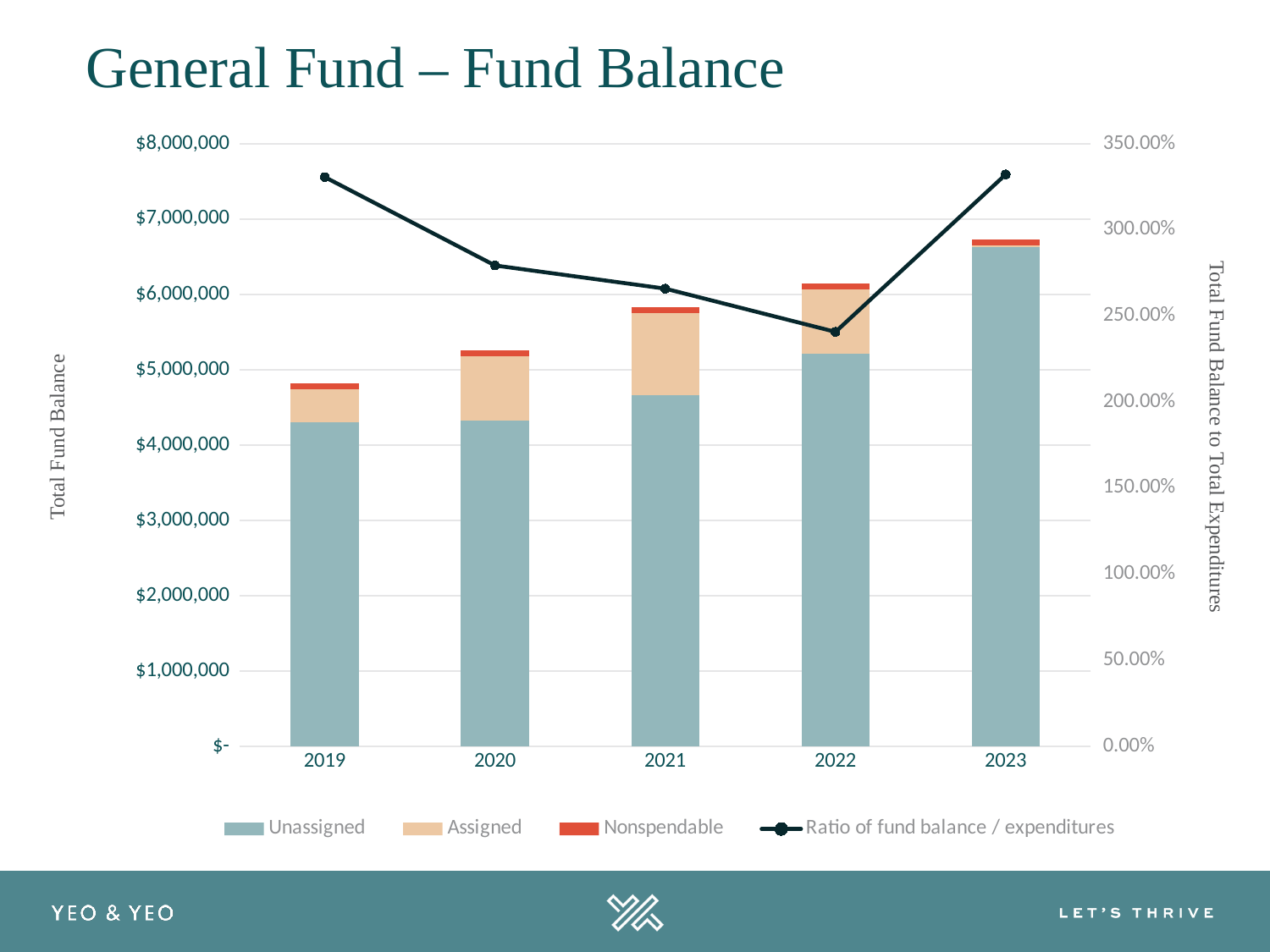
Is the total fund balance for 2019 greater or less than $5,000,000? less Which year has the largest Assigned segment? 2021 Does the total fund balance rise or fall from 2019 to 2023? rise How many series does the legend list? 4 What kind of chart is shown on the slide? A combination of a stacked bar chart and a line chart Which year has the highest total fund balance bar? 2023 Which year has the lowest total fund balance bar? 2019 What is the title of the chart? General Fund – Fund Balance Is the total fund balance for 2023 greater or less than $6,000,000? greater How many years are shown on the x axis? 5 Is the ratio of fund balance / expenditures for 2022 greater or less than 250.00%? less In which year is the ratio of fund balance / expenditures lowest? 2022